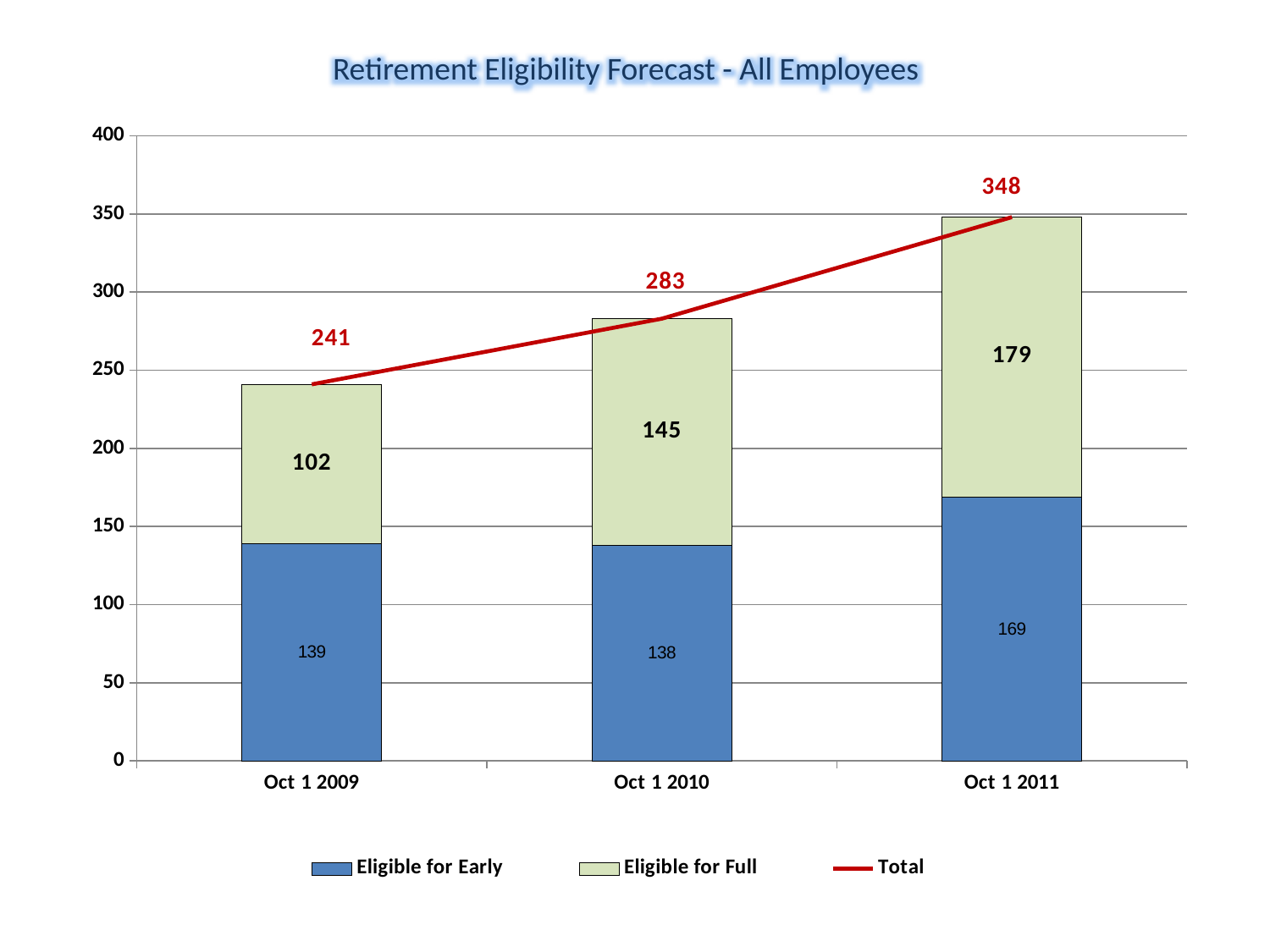
What kind of chart is this? Stacked bar chart with a line How many series does the legend list? 3 What is the value for Eligible for Full on Oct 1 2011? 179 Which is larger: Eligible for Early on Oct 1 2010 or Eligible for Full on Oct 1 2010? Eligible for Full Does the Total rise or fall from Oct 1 2009 to Oct 1 2011? Rise Which date has the highest Total? Oct 1 2011 Which date has the lowest Eligible for Full value? Oct 1 2009 Is the Total for Oct 1 2010 greater or less than 250? greater How many dates are shown on the x axis? 3 What is the value for Eligible for Early on Oct 1 2009? 139 What is the difference between the Total for Oct 1 2011 and the Total for Oct 1 2009? 107 What is the Total value for Oct 1 2010? 283